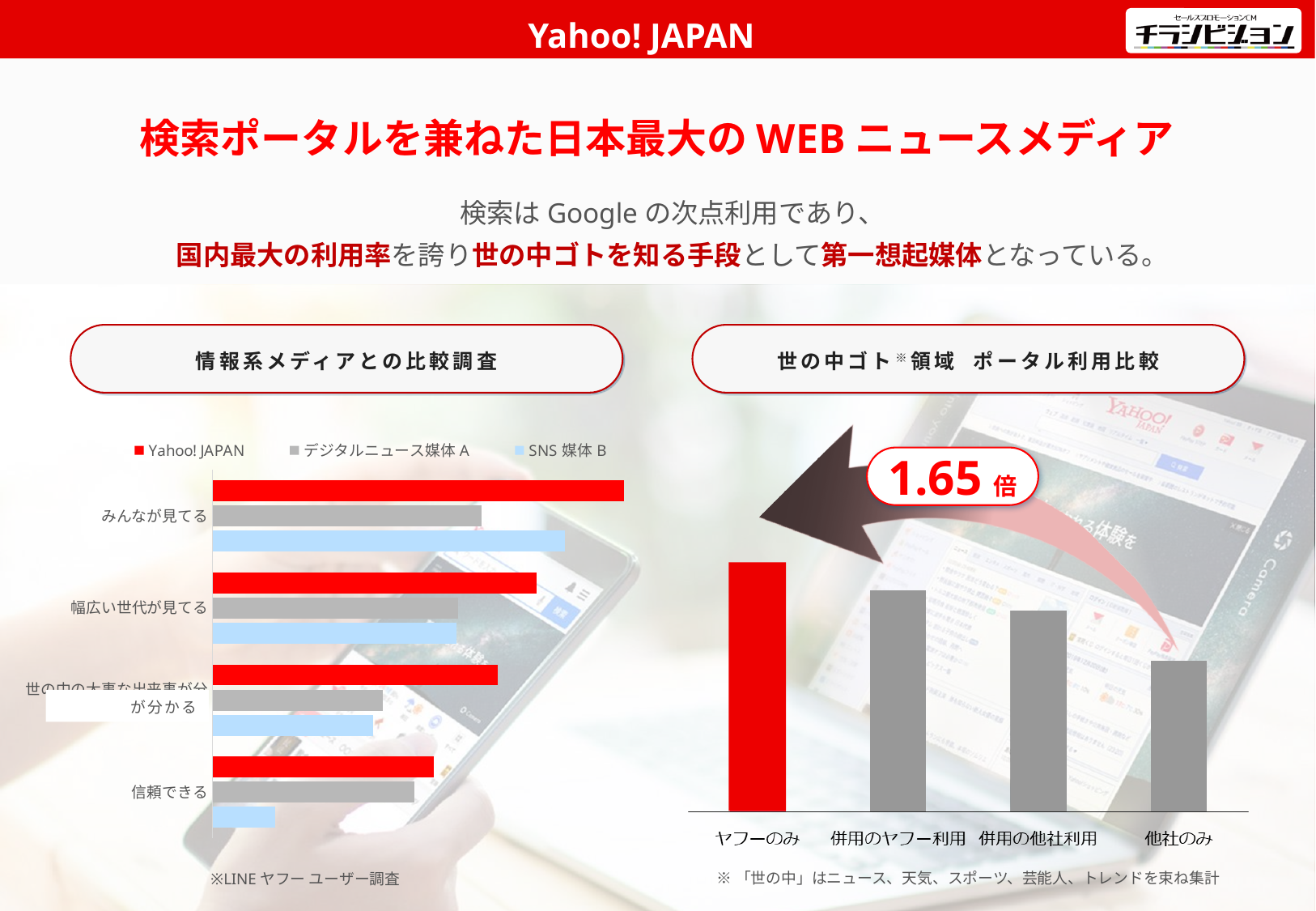
In the right chart 世の中ゴト※領域 ポータル利用比較, which category has the highest bar? ヤフーのみ In the left chart 情報系メディアとの比較調査, how many categories are shown on the vertical axis? 4 In the right chart 世の中ゴト※領域 ポータル利用比較, which is larger: 併用のヤフー利用 or 他社のみ? 併用のヤフー利用 In the left chart 情報系メディアとの比較調査, which series is shown in red? Yahoo! JAPAN In the right chart 世の中ゴト※領域 ポータル利用比較, how many bars are shown? 4 In the left chart 情報系メディアとの比較調査, for the category 信頼できる, which series has the longest bar? Yahoo! JAPAN In the left chart 情報系メディアとの比較調査, for the category 信頼できる, which series has the shortest bar? SNS 媒体 B In the left chart 情報系メディアとの比較調査, how many series does the legend list? 3 In the right chart 世の中ゴト※領域 ポータル利用比較, which category has the lowest bar? 他社のみ What kind of chart is the left chart titled 情報系メディアとの比較調査? Bar chart What multiplier is printed in the callout above the right chart 世の中ゴト※領域 ポータル利用比較? 1.65 倍 What kind of chart is the right chart titled 世の中ゴト※領域 ポータル利用比較? Bar chart